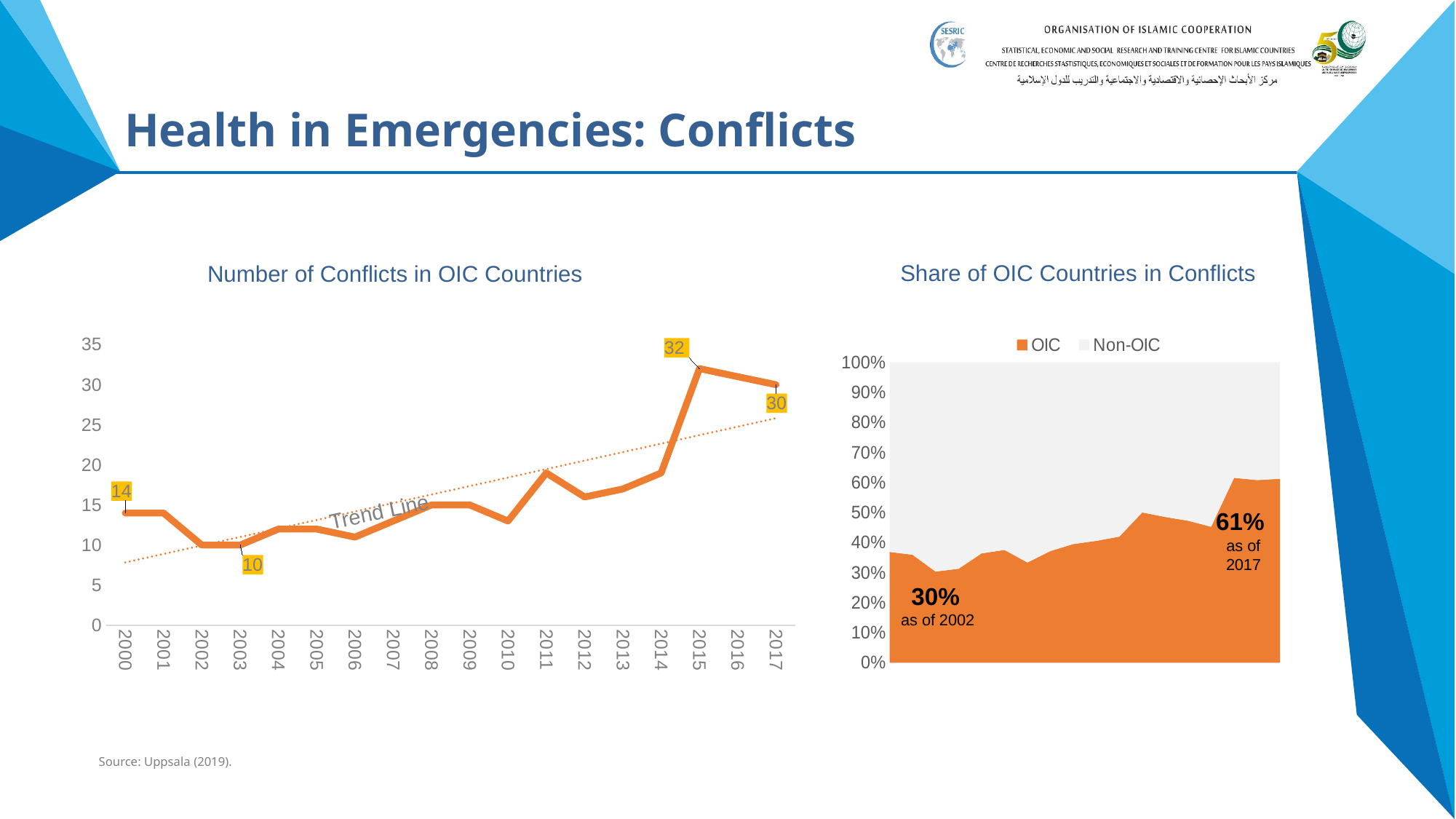
In the 'Number of Conflicts in OIC Countries' chart, what is the value for 2000? 14 In the 'Share of OIC Countries in Conflicts' chart, what is the OIC share as of 2017? 61% In the 'Number of Conflicts in OIC Countries' chart, what is the difference between the values for 2015 and 2003? 22 How many series does the legend of the 'Share of OIC Countries in Conflicts' chart list? 2 What kind of chart is 'Number of Conflicts in OIC Countries'? line chart In the 'Number of Conflicts in OIC Countries' chart, is the value for 2011 greater or less than 15? greater In the 'Number of Conflicts in OIC Countries' chart, what is the value for 2003? 10 In the 'Number of Conflicts in OIC Countries' chart, how many years are shown on the x axis? 18 In the 'Share of OIC Countries in Conflicts' chart, what is the OIC share as of 2002? 30% In the 'Number of Conflicts in OIC Countries' chart, which year has the highest number of conflicts? 2015 In the 'Number of Conflicts in OIC Countries' chart, what is the value for 2017? 30 In the 'Number of Conflicts in OIC Countries' chart, what is the value for 2015? 32